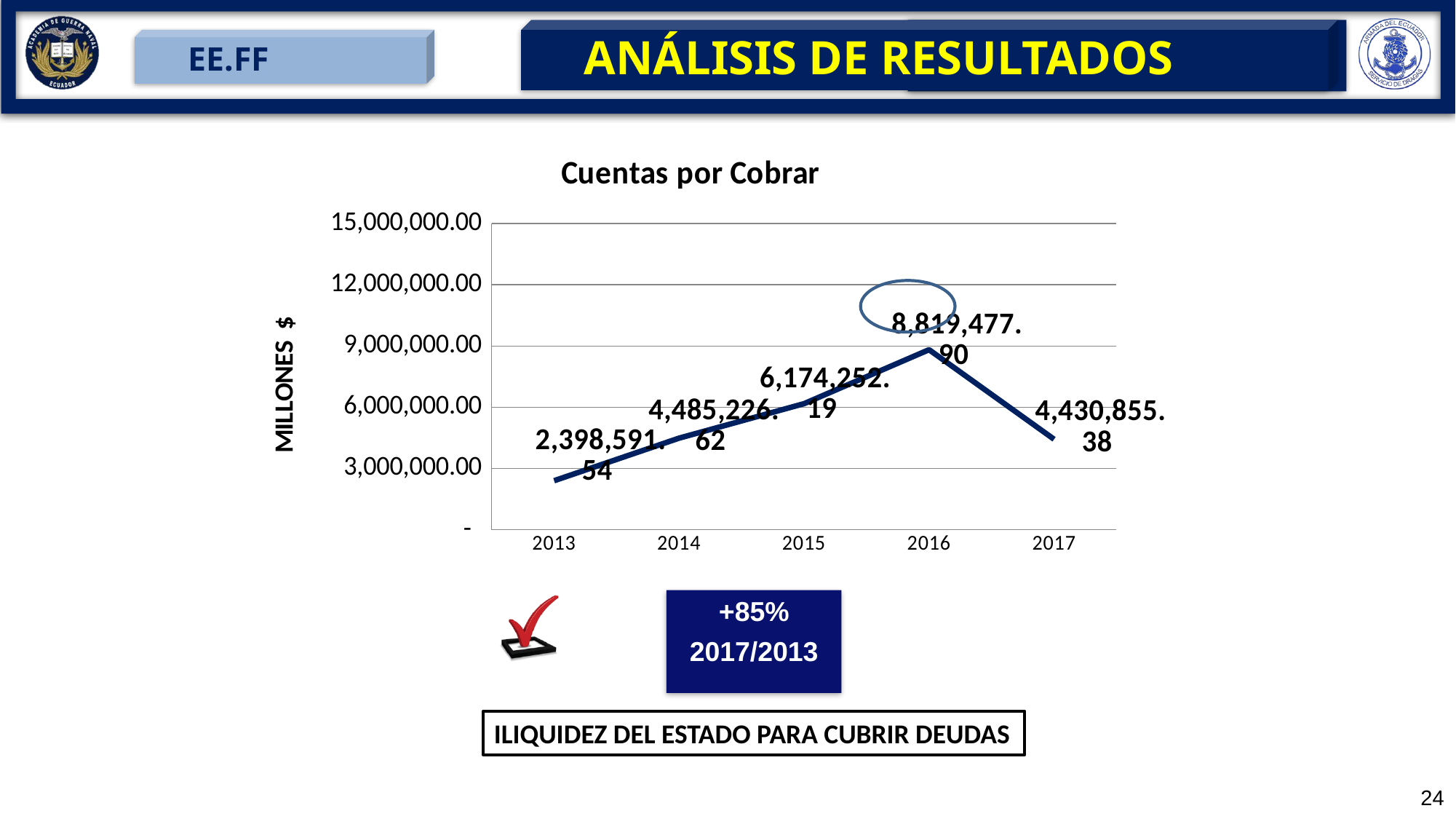
What is the value of Cuentas por Cobrar for 2017? 4,430,855.38 What type of chart is shown on the slide? Line chart Which is larger, the value for 2014 or the value for 2017? 2014 Which year has the highest value of Cuentas por Cobrar? 2016 What is the value of Cuentas por Cobrar for 2016? 8,819,477.90 What is the value of Cuentas por Cobrar for 2013? 2,398,591.54 What is the difference between the 2016 and 2017 values of Cuentas por Cobrar? 4,388,622.52 What is the title of the chart? Cuentas por Cobrar Is the value for 2013 greater or less than 3,000,000.00? less What is the label on the vertical axis of the chart? MILLONES $ Which year has the lowest value of Cuentas por Cobrar? 2013 How many years are plotted on the x axis of the chart? 5